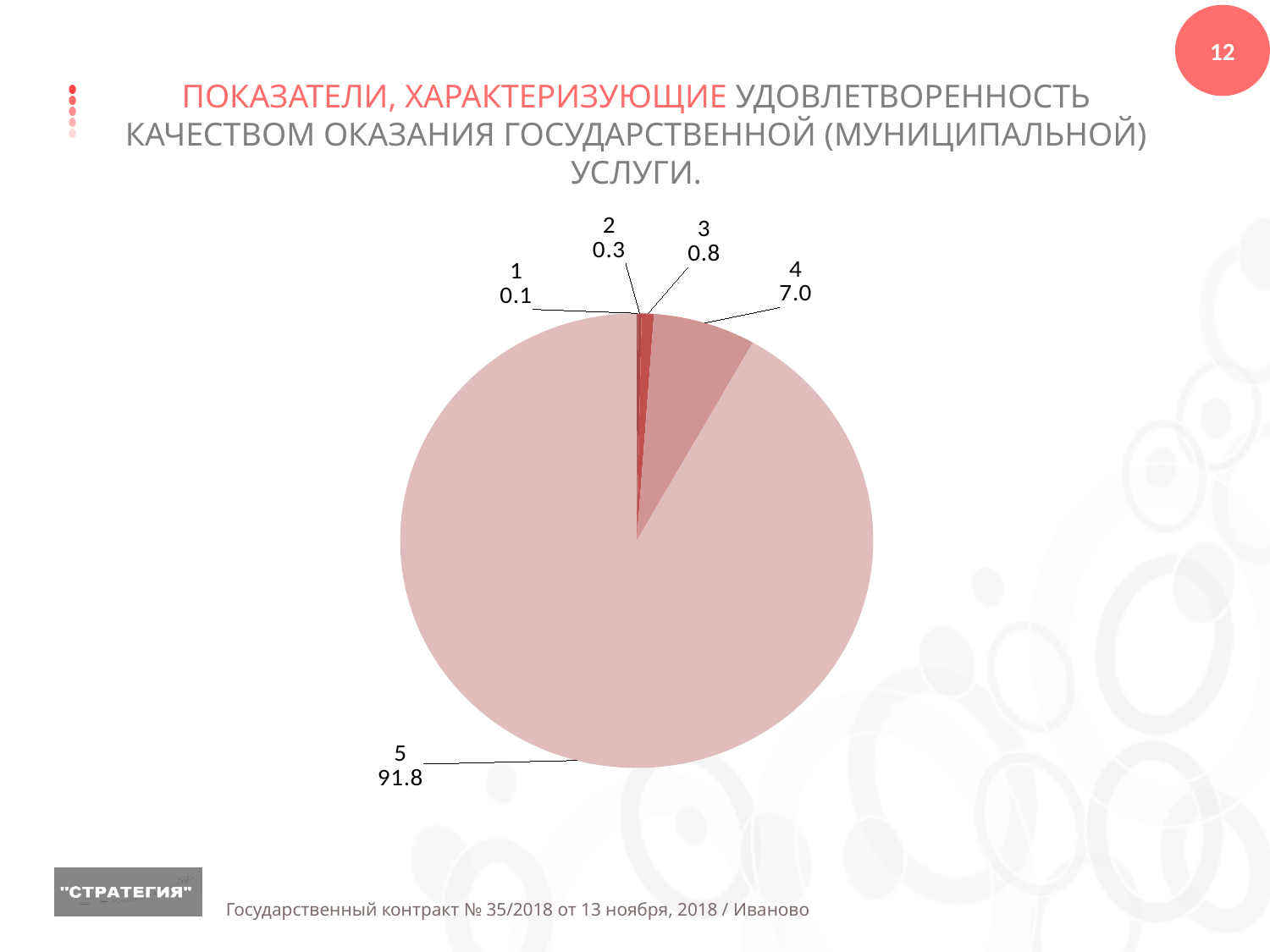
Which is larger, the value for category 3 or the value for category 2? category 3 What is the value for category 1 in the pie chart? 0.1 What is the value for category 4 in the pie chart? 7.0 How many slices does the pie chart have? 5 Which category has the smallest slice of the pie chart? 1 What is the combined value of categories 1, 2 and 3 in the pie chart? 1.2 What is the value for category 2 in the pie chart? 0.3 What is the difference between the values for category 5 and category 4? 84.8 What is the value for category 3 in the pie chart? 0.8 What kind of chart is shown on the slide? pie chart Which category has the largest slice of the pie chart? 5 What is the value for category 5 in the pie chart? 91.8